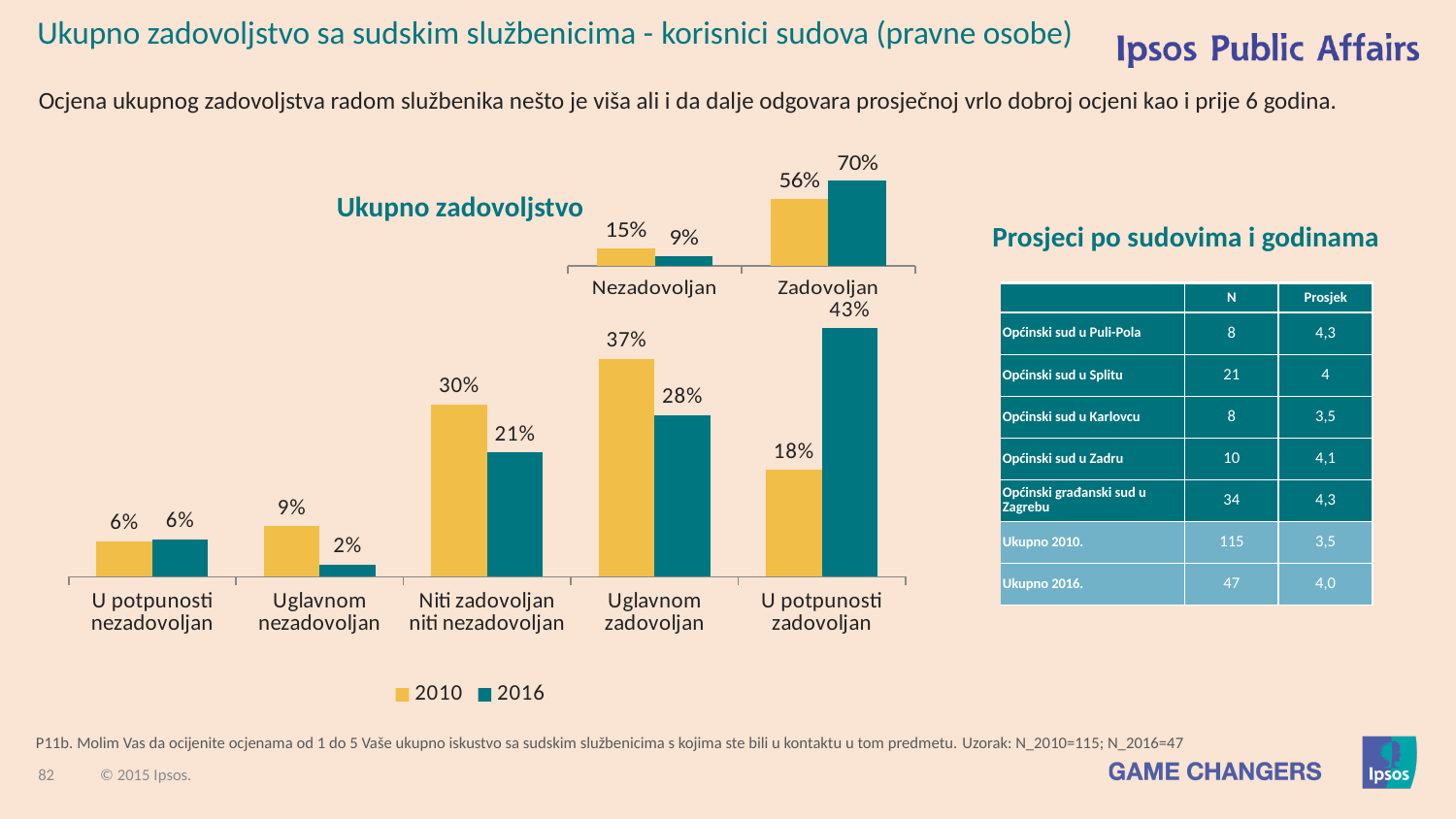
In the large bar chart on the left, which is larger for "Uglavnom zadovoljan": the 2010 value or the 2016 value? 2010 How many series does the legend of the large bar chart on the left list? 2 In the chart titled "Ukupno zadovoljstvo", what is the difference between the 2010 and 2016 values for "Nezadovoljan"? 6% In the large bar chart on the left, what is the 2010 value for "Niti zadovoljan niti nezadovoljan"? 30% In the large bar chart on the left, which category has the highest 2010 value? Uglavnom zadovoljan How many categories are shown on the x axis of the large bar chart on the left? 5 In the chart titled "Ukupno zadovoljstvo", what is the 2016 value for "Zadovoljan"? 70% In the large bar chart on the left, what is the difference between the 2016 and 2010 values for "U potpunosti zadovoljan"? 25% In the large bar chart on the left, which colour represents the 2016 series? Teal In the large bar chart on the left, which category has the lowest 2016 value? Uglavnom nezadovoljan What type of chart is the large chart on the left? Bar chart In the large bar chart on the left, what is the 2016 value for "U potpunosti zadovoljan"? 43%